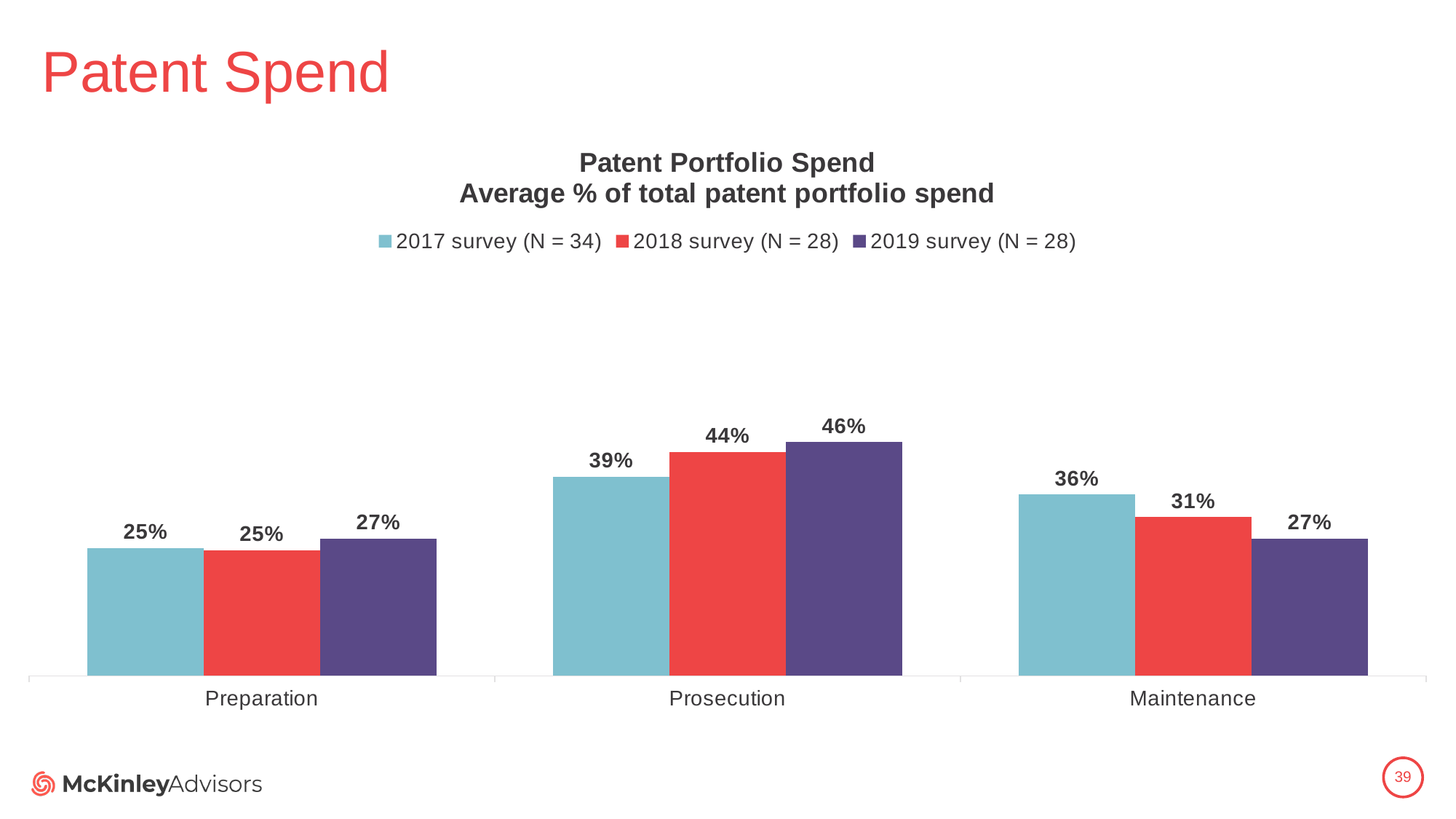
How many series does the legend list? 3 What is the value for Preparation in the 2018 survey (N = 28) series? 25% What is the difference between the 2019 survey and 2017 survey values for Prosecution? 7% Which is larger for Maintenance: the 2018 survey value or the 2019 survey value? 2018 survey What is the difference between the 2019 survey and 2017 survey values for Maintenance? 9% Across the three surveys, do the values for Maintenance rise or fall from 2017 to 2019? Fall Which category has the highest value in the 2018 survey (N = 28) series? Prosecution How many categories are shown on the x axis? 3 What is the value for Prosecution in the 2019 survey (N = 28) series? 46% What is the value for Maintenance in the 2017 survey (N = 34) series? 36% What kind of chart is shown on the slide? Bar chart Which category has the lowest value in the 2017 survey (N = 34) series? Preparation